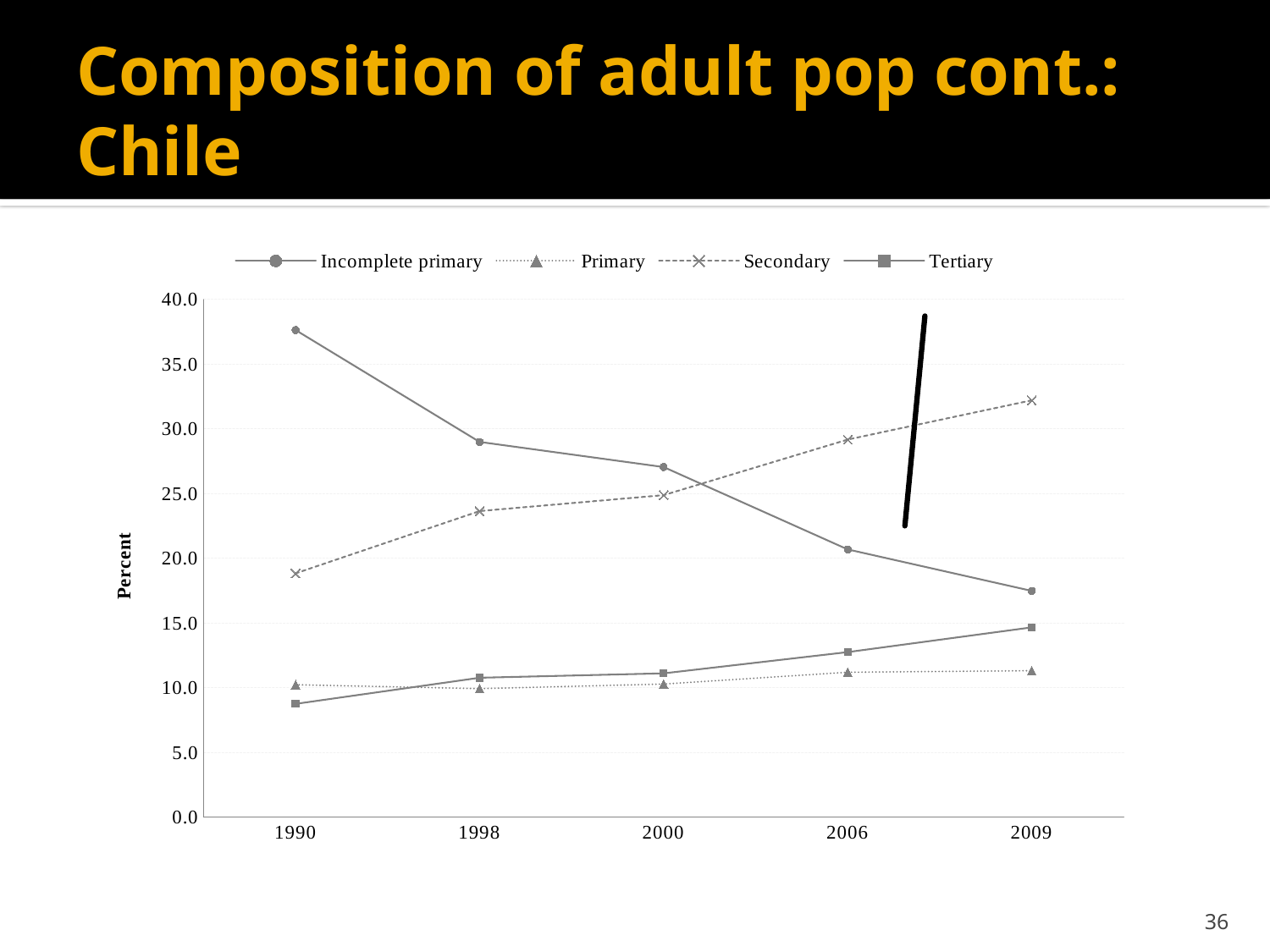
Does the Incomplete primary series rise or fall from 1990 to 2009? fall What is the label on the y axis? Percent In 2006, which is larger: Incomplete primary or Secondary? Secondary Which series has the lowest value in 1990? Tertiary Which series has the highest value in 1990? Incomplete primary What kind of chart is shown on the slide? line chart Is the value for Incomplete primary in 1990 greater or less than 35.0? greater Is the value for Secondary in 2009 greater or less than 30.0? greater Does the Secondary series rise or fall from 1990 to 2009? rise How many series does the legend list? 4 How many years are plotted along the x axis? 5 Which series has the highest value in 2009? Secondary